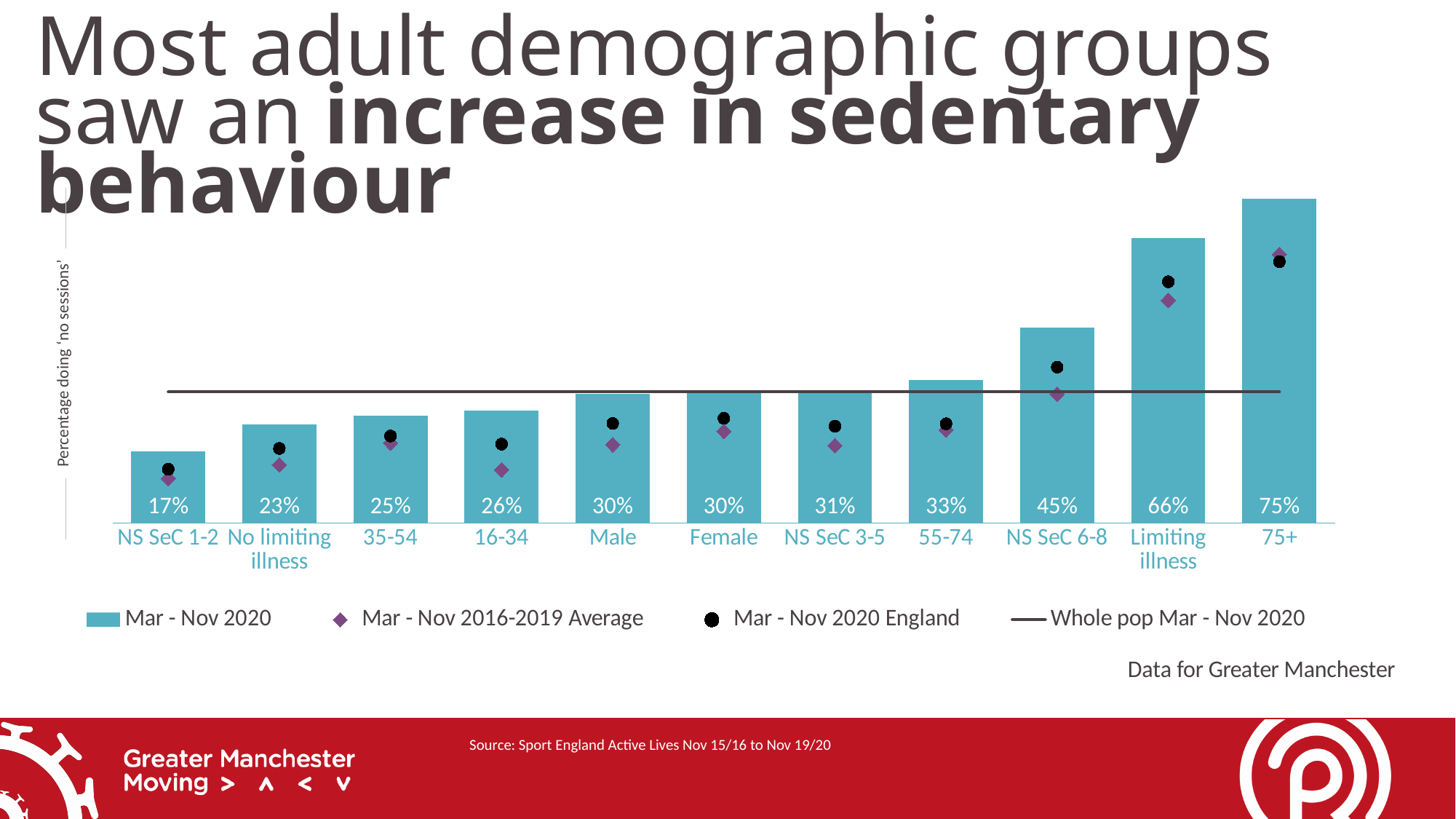
How many series does the legend list? 4 What kind of chart is shown on the slide? Bar chart What is the Mar - Nov 2020 value for NS SeC 6-8? 45% How many demographic groups are shown on the x axis? 11 Which has a larger Mar - Nov 2020 value, 55-74 or 16-34? 55-74 Which demographic group has the highest Mar - Nov 2020 value? 75+ What is the Mar - Nov 2020 value for the Limiting illness group? 66% Do the Mar - Nov 2020 bar values rise or fall from left to right along the x axis? Rise Which legend entry is represented by the horizontal line across the chart? Whole pop Mar - Nov 2020 What is the difference between the Mar - Nov 2020 values for Limiting illness and No limiting illness? 43% What is the Mar - Nov 2020 value for the 75+ group? 75% Which demographic group has the lowest Mar - Nov 2020 value? NS SeC 1-2